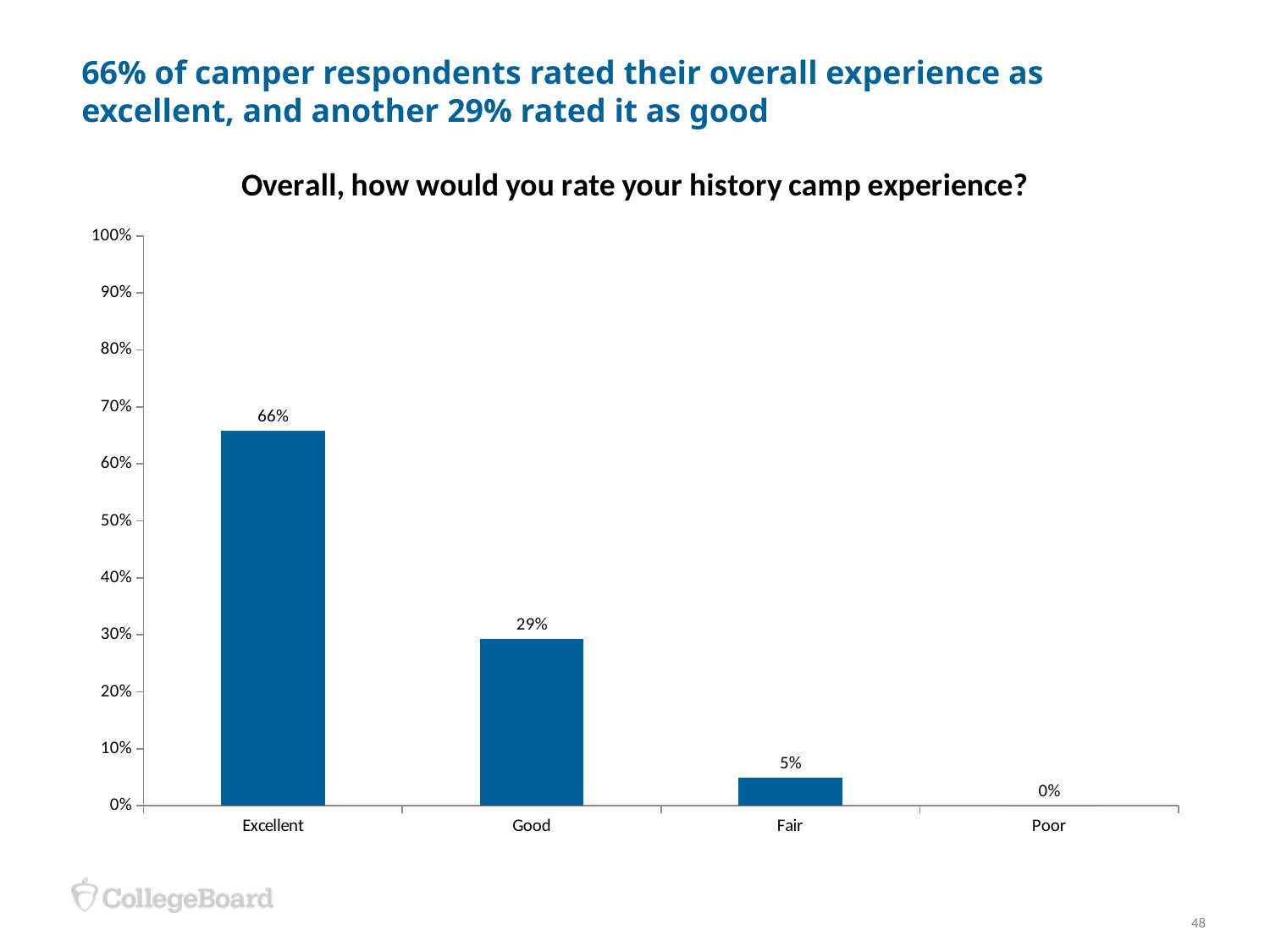
What is the title of the chart? Overall, how would you rate your history camp experience? What percentage of respondents rated their history camp experience as Excellent? 66% Which rating received a larger share of respondents, Good or Fair? Good What percentage of respondents rated their history camp experience as Good? 29% Which rating category has the highest percentage of respondents? Excellent What is the difference in percentage points between the Excellent and Good ratings? 37 Which rating category has the lowest percentage of respondents? Poor What percentage of respondents rated their history camp experience as Poor? 0% What percentage of respondents rated their history camp experience as Fair? 5% How many rating categories are shown on the x axis? 4 What type of chart is used on this slide? Bar chart What is the difference in percentage points between the Good and Fair ratings? 24